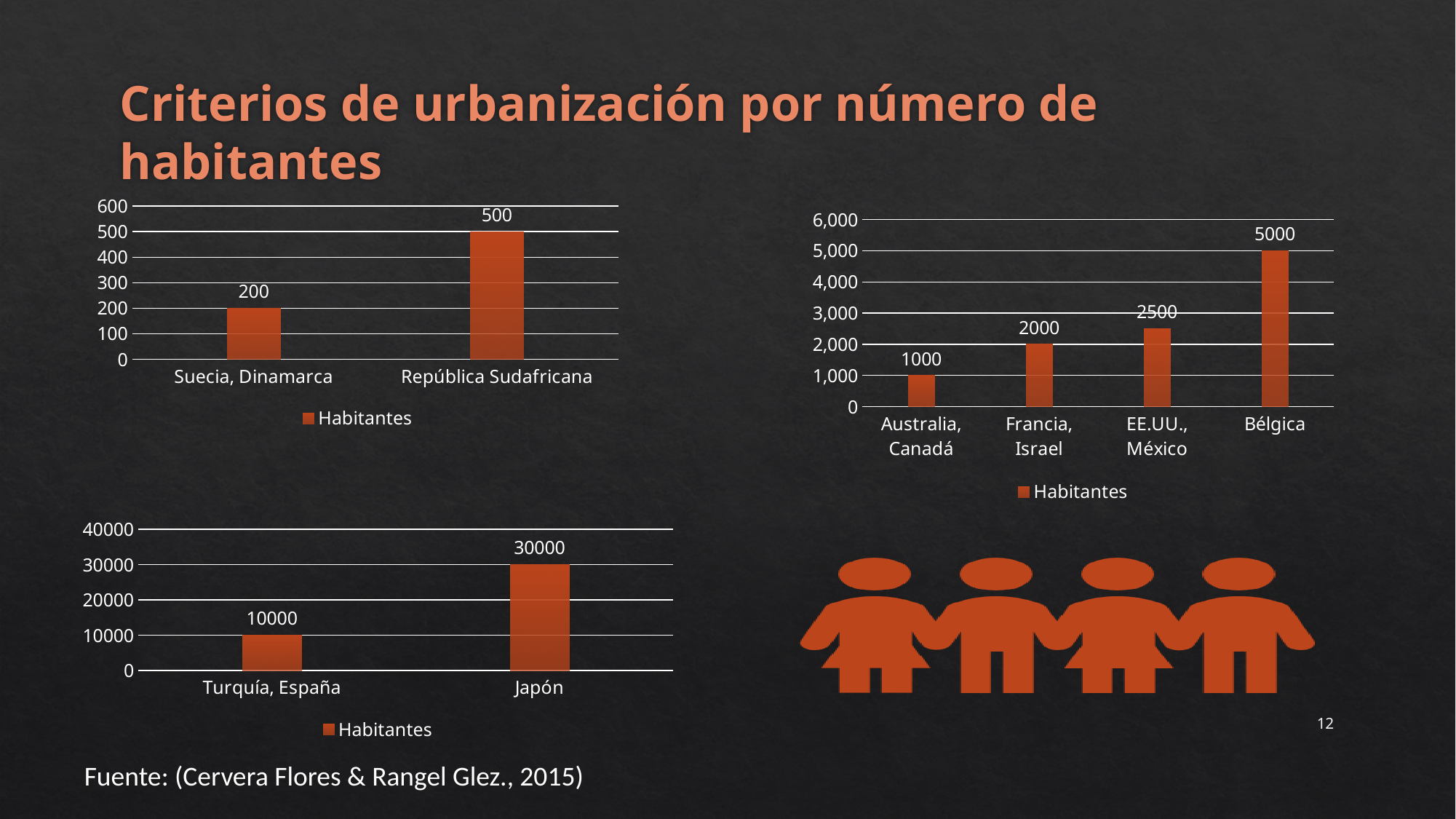
In the top-left chart, what is the difference between República Sudafricana and Suecia, Dinamarca? 300 In the bottom-left chart, what is the difference between Japón and Turquía, España? 20000 In the top-left chart, what is the value for República Sudafricana? 500 In the top-right chart, what is the value for EE.UU., México? 2500 How many categories are shown in the top-right chart? 4 In the top-right chart, which category has the lowest value? Australia, Canadá How many series does the legend of the top-right chart list? 1 In the top-right chart, which category has the highest value? Bélgica In the top-left chart, what is the value for Suecia, Dinamarca? 200 What kind of chart is the bottom-left chart? Bar chart In the top-right chart, what is the value for Francia, Israel? 2000 In the bottom-left chart, what is the value for Japón? 30000